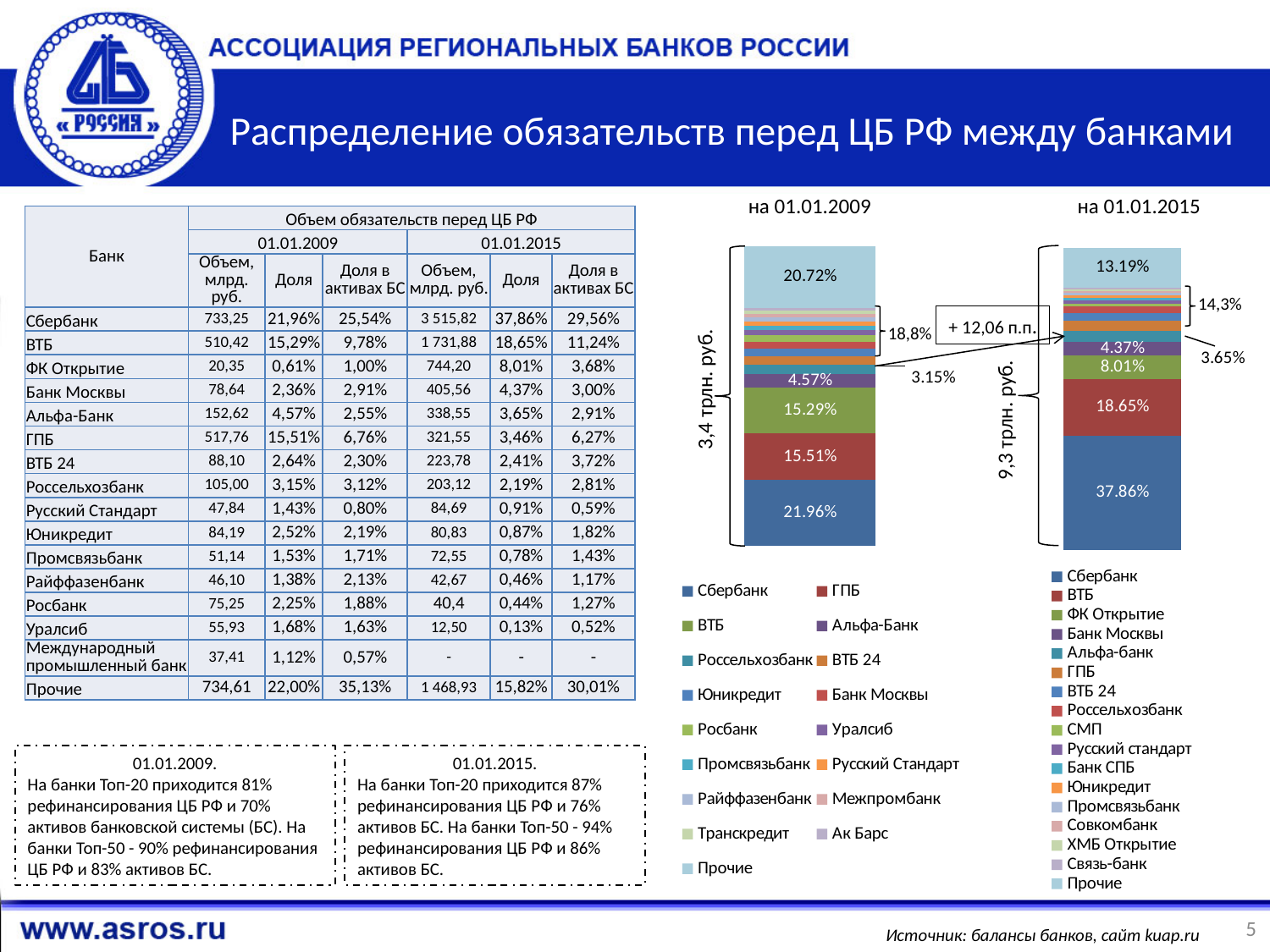
In the chart 'на 01.01.2009', what share is shown for the bottom segment (Сбербанк)? 21.96% What total volume is written beside the bar in the chart 'на 01.01.2015'? 9,3 трлн. руб. In the chart 'на 01.01.2009', which is larger: the ГПБ segment or the ВТБ segment? ГПБ (15.51%) In the chart 'на 01.01.2015', what share is shown for the bottom segment (Сбербанк)? 37.86% In the chart 'на 01.01.2015', what share is labelled for the ФК Открытие segment? 8.01% By how many percentage points does the Сбербанк share in the chart 'на 01.01.2015' exceed its share in the chart 'на 01.01.2009'? 15.90 percentage points In the chart 'на 01.01.2009', which labelled segment has the largest share? Сбербанк (21.96%) In the chart 'на 01.01.2015', what share is labelled for the ВТБ segment (second from the bottom)? 18.65% In the chart 'на 01.01.2009', which labelled segment has the smallest share? Россельхозбанк (3.15%) What type of chart is used for 'на 01.01.2009' and 'на 01.01.2015'? Stacked bar chart In the chart 'на 01.01.2009', what share is labelled for the top segment (Прочие)? 20.72% How many entries does the legend of the chart 'на 01.01.2015' list? 17